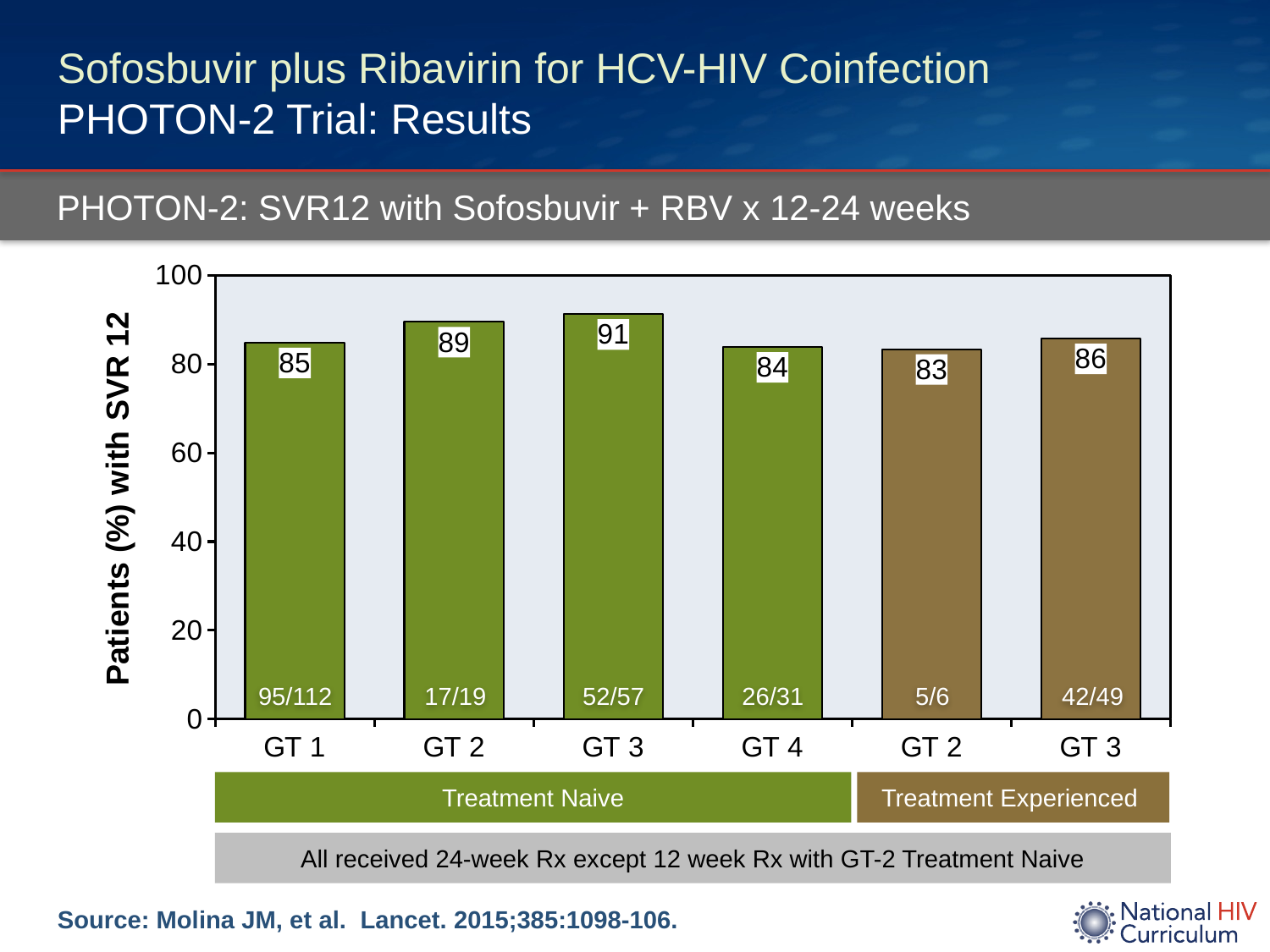
How many bars are shown in the chart? 6 Which bar has the lowest SVR12 rate? GT 2 Treatment Experienced What is the SVR12 rate for GT 4 in the Treatment Naive group? 84 What is the patient fraction shown inside the GT 2 Treatment Experienced bar? 5/6 What is the difference in SVR12 rate between GT 3 Treatment Naive and GT 2 Treatment Experienced? 8 What kind of chart is shown on the slide? Bar chart What is the label of the y-axis? Patients (%) with SVR 12 What is the SVR12 rate for GT 1 in the Treatment Naive group? 85 What is the patient fraction shown inside the GT 1 Treatment Naive bar? 95/112 Which has a higher SVR12 rate: GT 2 Treatment Naive or GT 2 Treatment Experienced? GT 2 Treatment Naive What is the SVR12 rate for GT 3 in the Treatment Experienced group? 86 Which bar has the highest SVR12 rate? GT 3 Treatment Naive